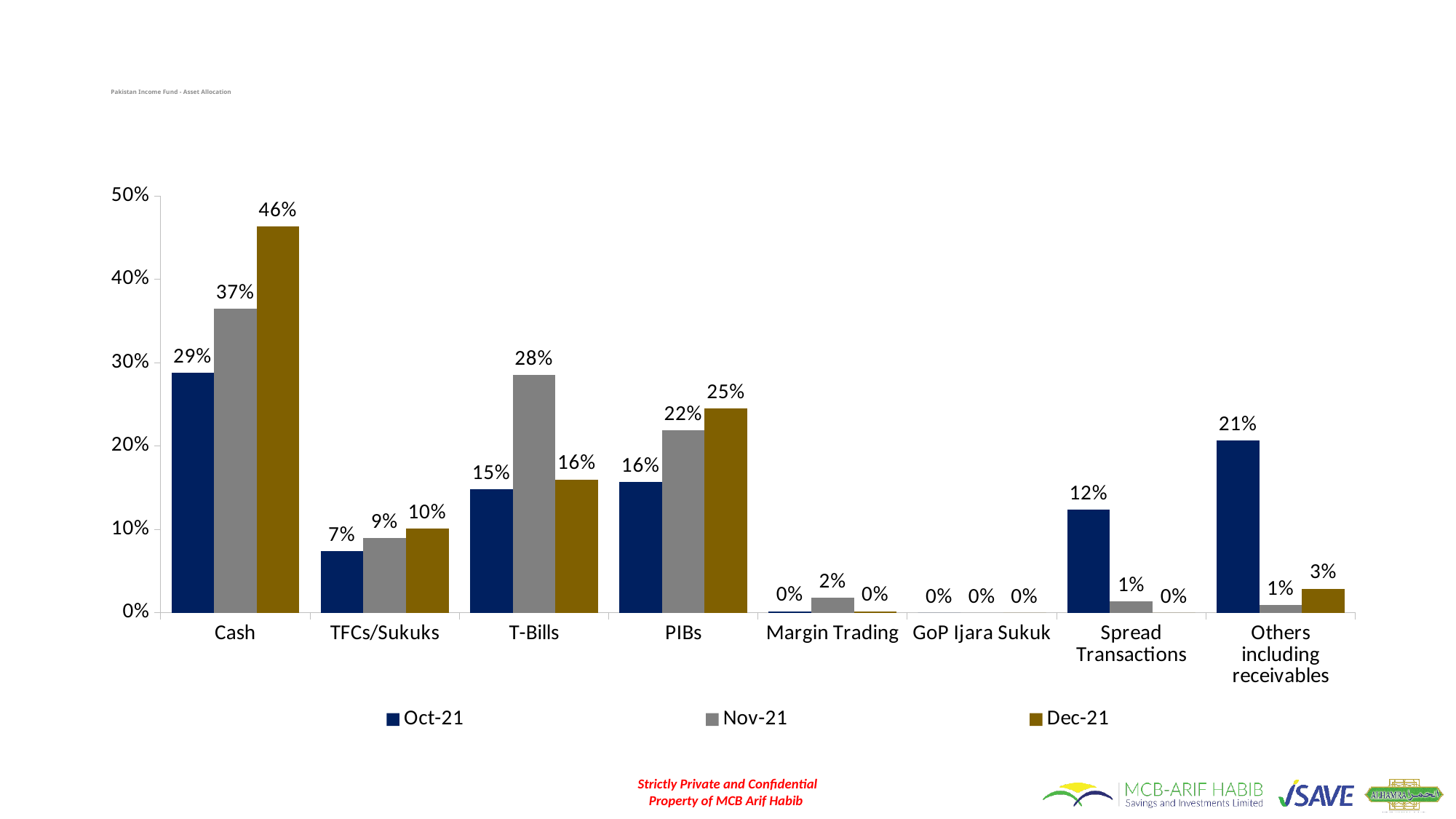
Which is larger for PIBs: the Oct-21 value or the Dec-21 value? Dec-21 Which category has the highest Oct-21 value? Cash What is the Nov-21 value for T-Bills? 28% Which category has the highest Dec-21 value? Cash What kind of chart is shown on the slide? Bar chart What is the Oct-21 value for Others including receivables? 21% What is the difference between the Dec-21 and Oct-21 values for Cash? 17% How many series does the legend list? 3 What is the title of the chart? Pakistan Income Fund - Asset Allocation How many categories are shown on the x axis? 8 What is the difference between the Nov-21 and Dec-21 values for T-Bills? 12% What is the Dec-21 value for Cash? 46%